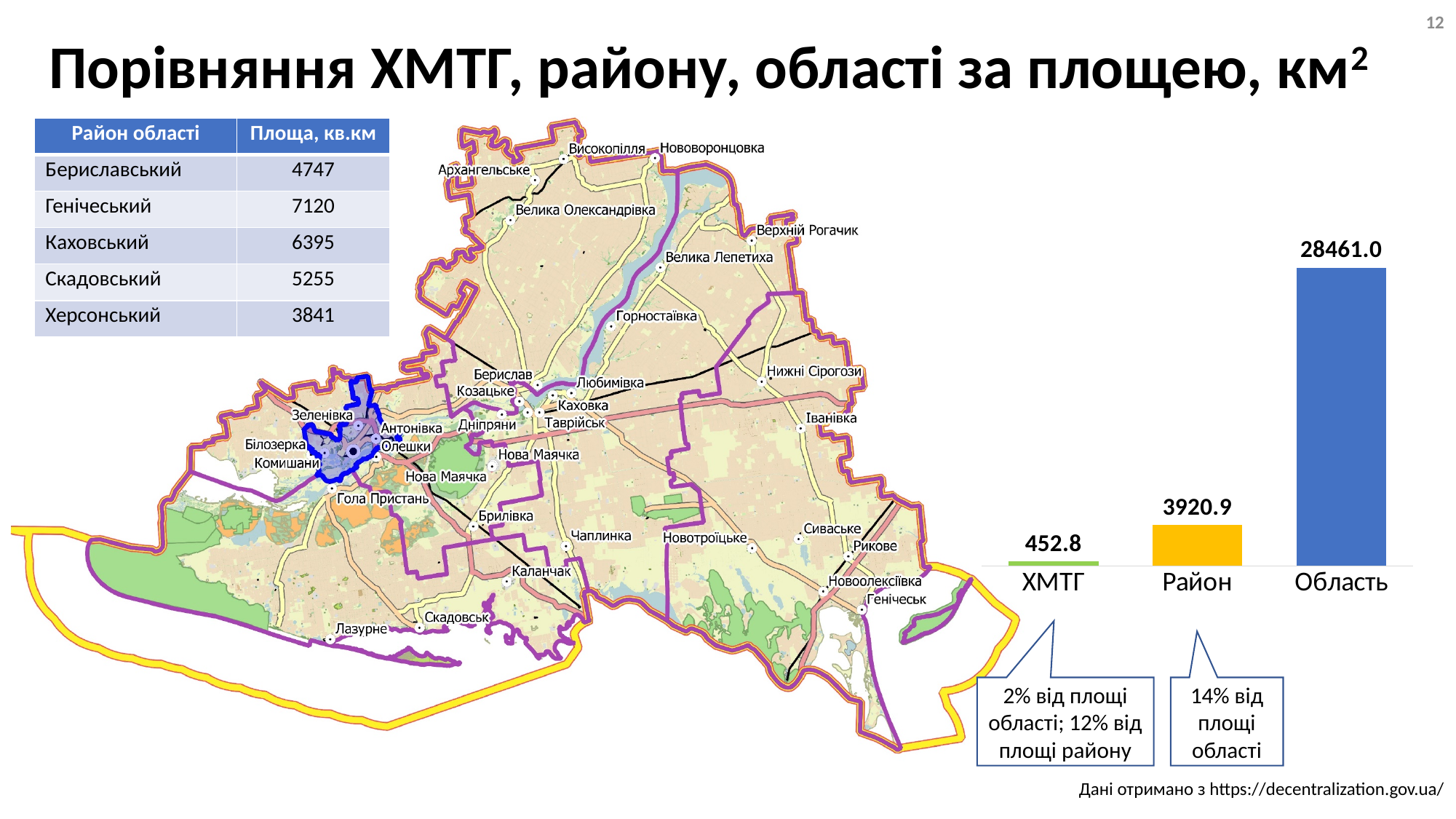
How many categories are shown in the bar chart? 3 Which category has the lowest value in the bar chart? ХМТГ What is the value shown for Область in the bar chart? 28461.0 Do the values in the bar chart rise or fall from left to right? Rise What is the difference between the values for Область and Район in the bar chart? 24540.1 What is the value shown for ХМТГ in the bar chart? 452.8 What is the difference between the values for Район and ХМТГ in the bar chart? 3468.1 What colour is the bar for Область in the bar chart? Blue Which is larger in the bar chart, the value for Район or the value for ХМТГ? Район What kind of chart is used to compare ХМТГ, Район and Область? Bar chart Which category has the highest value in the bar chart? Область What is the value shown for Район in the bar chart? 3920.9